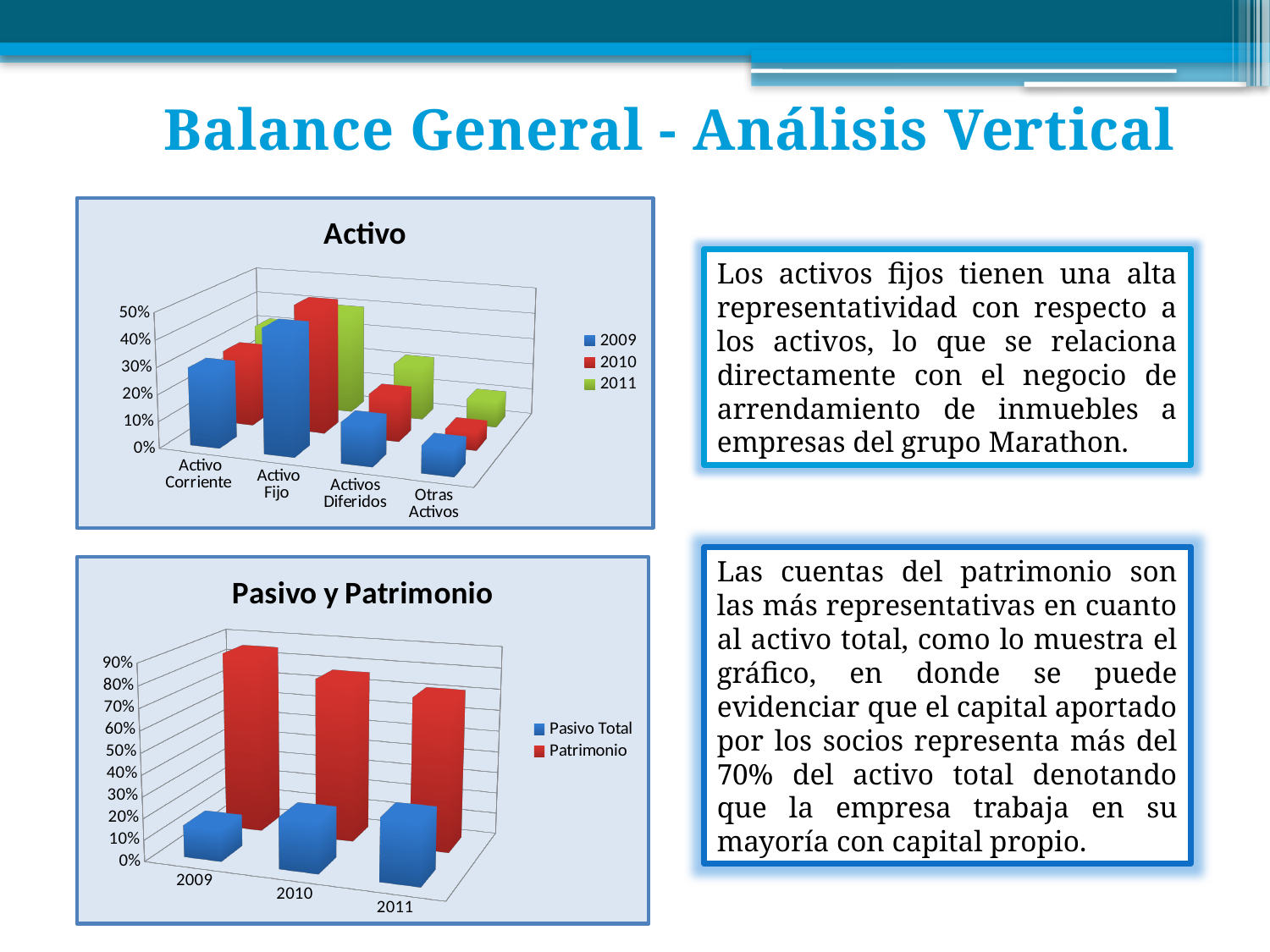
In the 'Pasivo y Patrimonio' chart, which is larger in 2011: Pasivo Total or Patrimonio? Patrimonio In the 'Pasivo y Patrimonio' chart, is the Patrimonio value for 2009 greater or less than 70%? greater What is the title of the lower chart on the slide? Pasivo y Patrimonio How many series does the legend of the 'Pasivo y Patrimonio' chart list? 2 How many series does the legend of the 'Activo' chart list? 3 What kind of chart is the 'Activo' chart? bar chart In the 'Activo' chart, which is larger for 2011: Activo Fijo or Activos Diferidos? Activo Fijo In the 'Activo' chart, which category has the lowest value for 2009? Otras Activos In the 'Activo' chart, which category has the highest value for 2010? Activo Fijo How many categories are shown on the x axis of the 'Activo' chart? 4 In the 'Pasivo y Patrimonio' chart, does the Patrimonio series rise or fall from 2009 to 2011? fall In the 'Activo' chart, is the 2010 value for Activo Fijo greater or less than 30%? greater